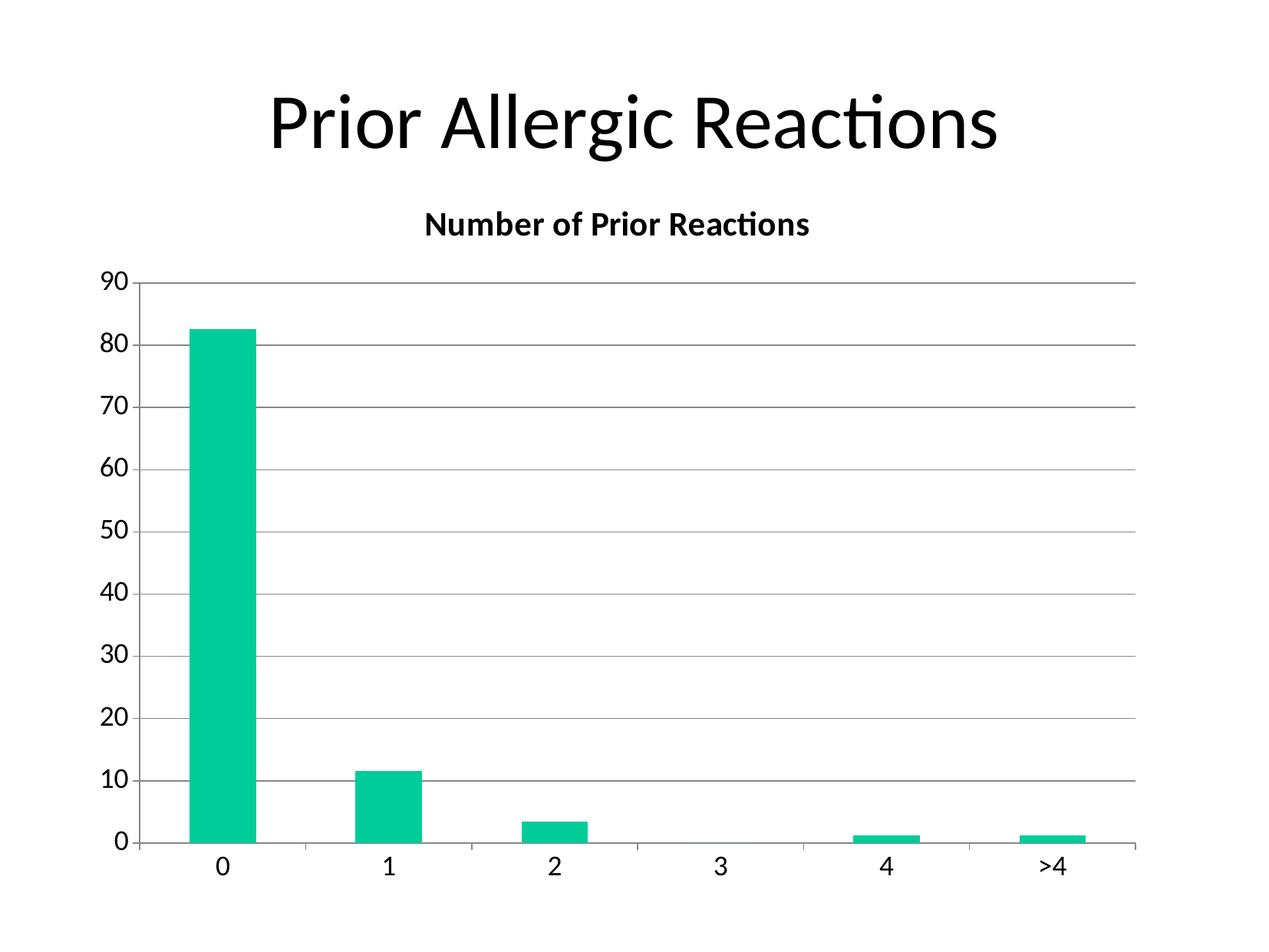
Is the value for category 1 greater or less than 10? greater What kind of chart is shown on the slide? bar chart Which category has the lowest bar in the chart? 3 Which is larger, the value for category 0 or the value for category 1? 0 Which category has the highest bar in the chart? 0 Which is larger, the value for category 1 or the value for category 2? 1 Is the value for category 2 greater or less than 10? less Is the value for category 0 greater or less than 80? greater What is the title of the chart? Number of Prior Reactions How many categories are shown on the x axis of the chart? 6 Do the bar values generally rise or fall from category 0 to category 3 along the x axis? fall